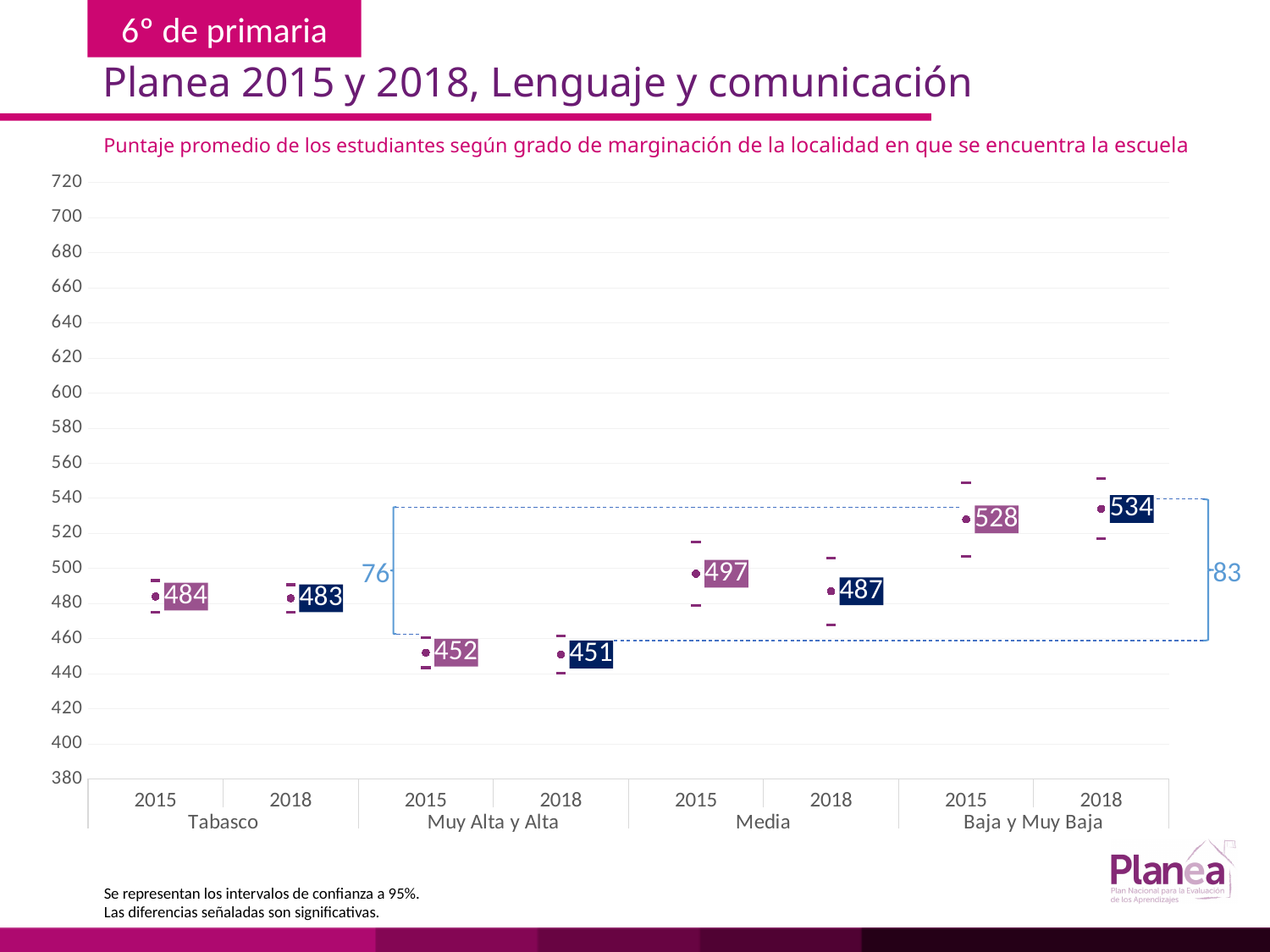
What is the 2015 average score for the Baja y Muy Baja marginación group? 528 Which group and year has the lowest average score on the chart? Muy Alta y Alta, 2018 What is the 2018 average score for the Media marginación group? 487 What is the subtitle of the chart? Puntaje promedio de los estudiantes según grado de marginación de la localidad en que se encuentra la escuela What is the difference between the 2018 scores of Baja y Muy Baja and Muy Alta y Alta? 83 What is the 2018 average score for the Muy Alta y Alta marginación group? 451 What is the difference between the 2015 and 2018 average scores for the Media group? 10 What is the 2015 average score for Tabasco? 484 Which group and year has the highest average score on the chart? Baja y Muy Baja, 2018 Which is larger, the 2015 score for Media or the 2015 score for Tabasco? Media, 2015 Did the average score for Baja y Muy Baja rise or fall from 2015 to 2018? rise How many data points are plotted on the chart? 8